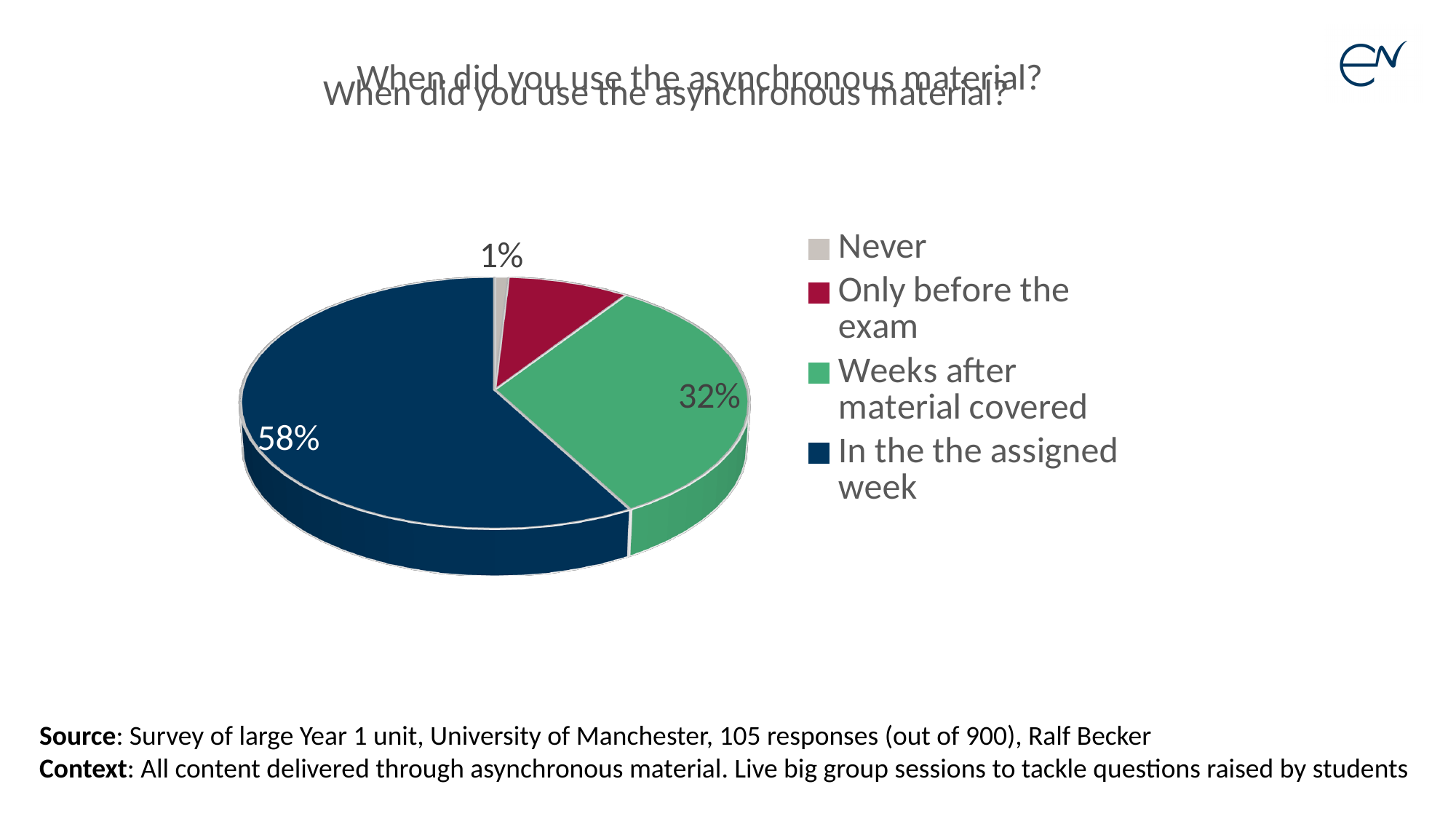
What is the difference in percentage points between "Weeks after material covered" and "Never"? 31 What share of the pie is labelled for "Never"? 1% What is the title of the chart? When did you use the asynchronous material? What colour is the slice for "Only before the exam"? red What kind of chart is shown on the slide? pie chart What share of the pie is labelled for "Weeks after material covered"? 32% How many categories does the legend list? 4 What share of the pie is labelled for "In the the assigned week"? 58% Which category has the smallest slice of the pie? Never Which is larger: the share for "Weeks after material covered" or the share for "Only before the exam"? Weeks after material covered Which category has the largest slice of the pie? In the the assigned week What is the difference in percentage points between "In the the assigned week" and "Weeks after material covered"? 26